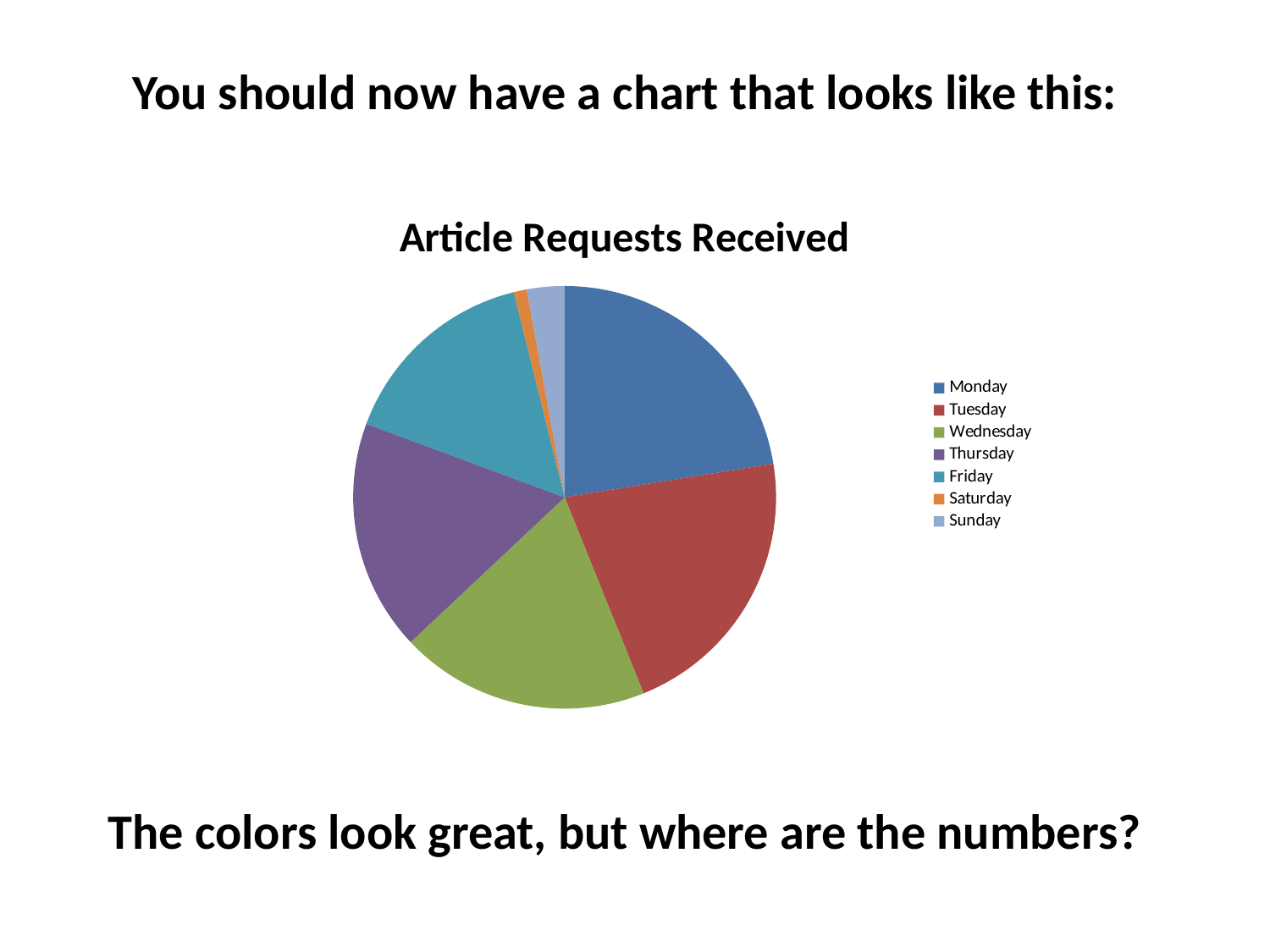
Which slice is larger, Thursday or Saturday? Thursday What kind of chart is shown on the slide? pie chart Which day has the smallest slice of the pie? Saturday Are any data labels or values printed on the pie slices? No Which slice is larger, Wednesday or Sunday? Wednesday How many categories (slices) does the pie chart have? 7 What is the title of the chart? Article Requests Received Which slice is larger, Monday or Friday? Monday Which legend entry is listed first? Monday How many entries does the legend list? 7